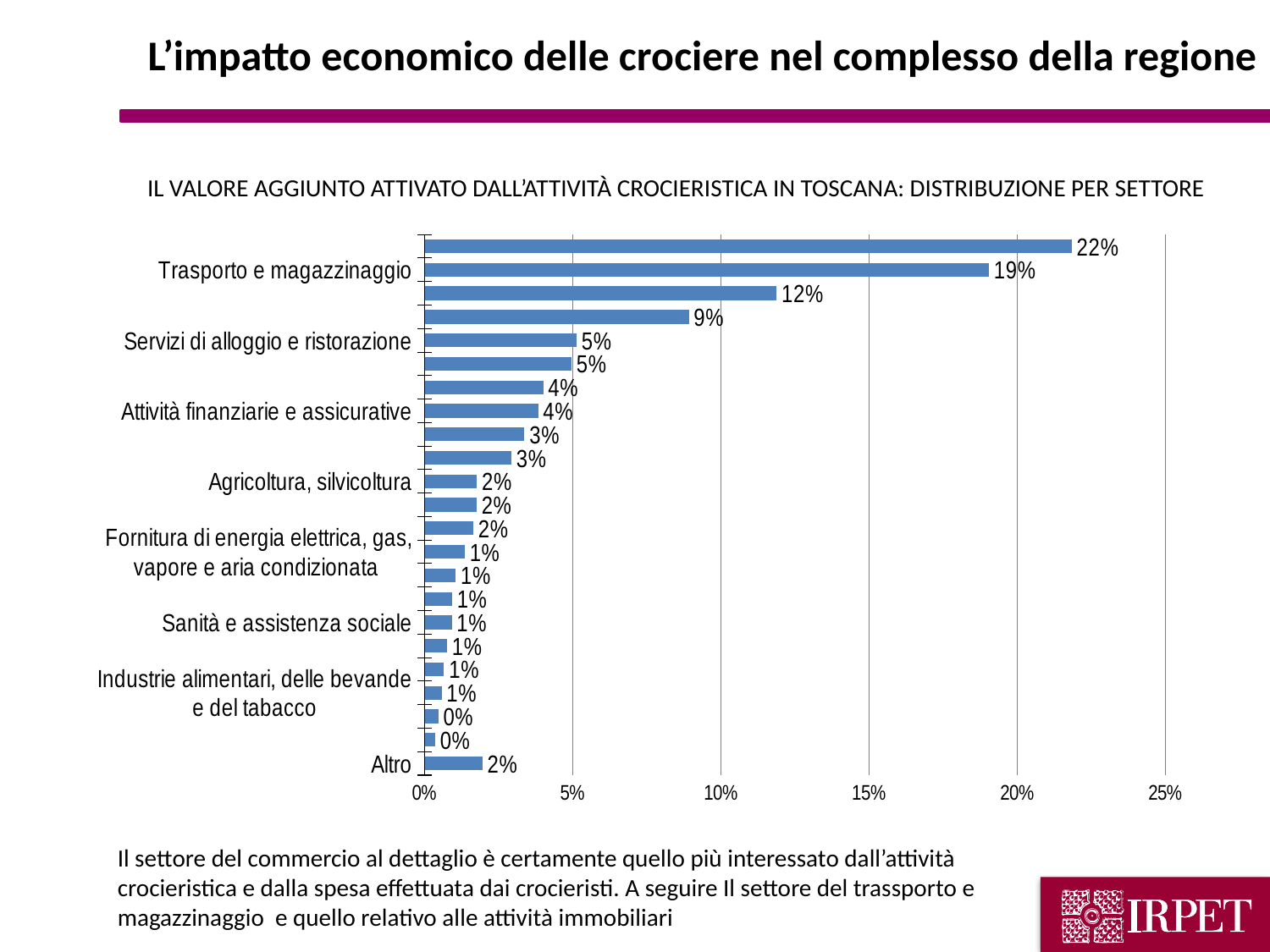
What is the value for Agricoltura, silvicoltura? 2% What is the value for Attività finanziarie e assicurative? 4% What is the highest value shown by any bar in the chart? 22% What is the value for Altro? 2% What is the difference between the values for Trasporto e magazzinaggio and Servizi di alloggio e ristorazione? 14 percentage points Which is larger, the value for Trasporto e magazzinaggio or the value for Altro? Trasporto e magazzinaggio How many bars are plotted in the chart? 23 What is the value for Servizi di alloggio e ristorazione? 5% Is the value for Trasporto e magazzinaggio greater or less than 15%? greater What is the value for Trasporto e magazzinaggio? 19% What is the value for Sanità e assistenza sociale? 1% What kind of chart is shown on the slide? bar chart